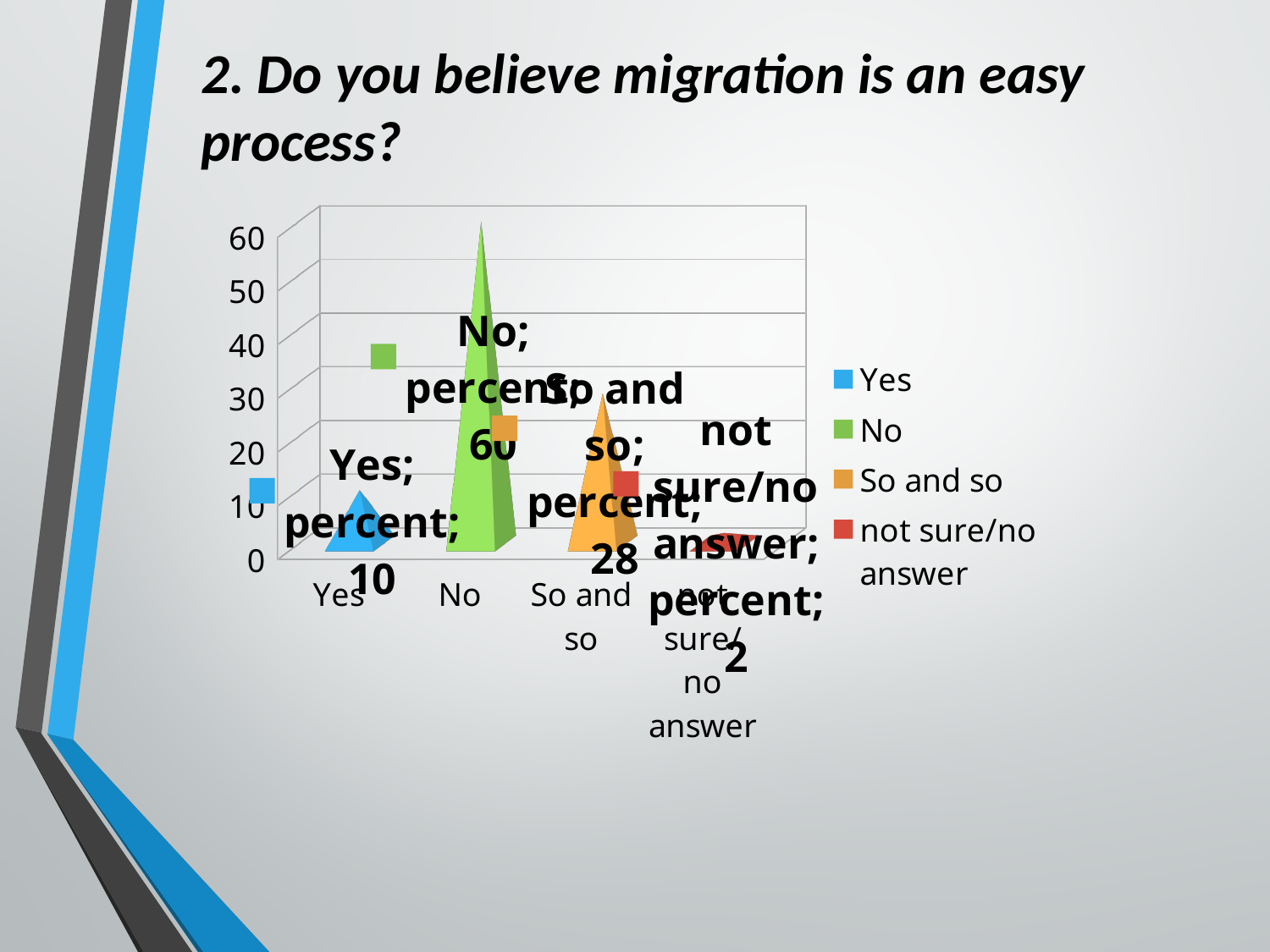
What is the value for No? 60 How many categories are shown on the x axis? 4 What kind of chart is shown on the slide? bar chart Which category has the highest value? No Which is larger, the value for Yes or the value for So and so? So and so What is the value for So and so? 28 What is the difference between the values for No and So and so? 32 How many entries does the legend list? 4 What is the value for not sure/no answer? 2 What is the value for Yes? 10 Is the value for No greater or less than 50? greater Which category has the lowest value? not sure/no answer